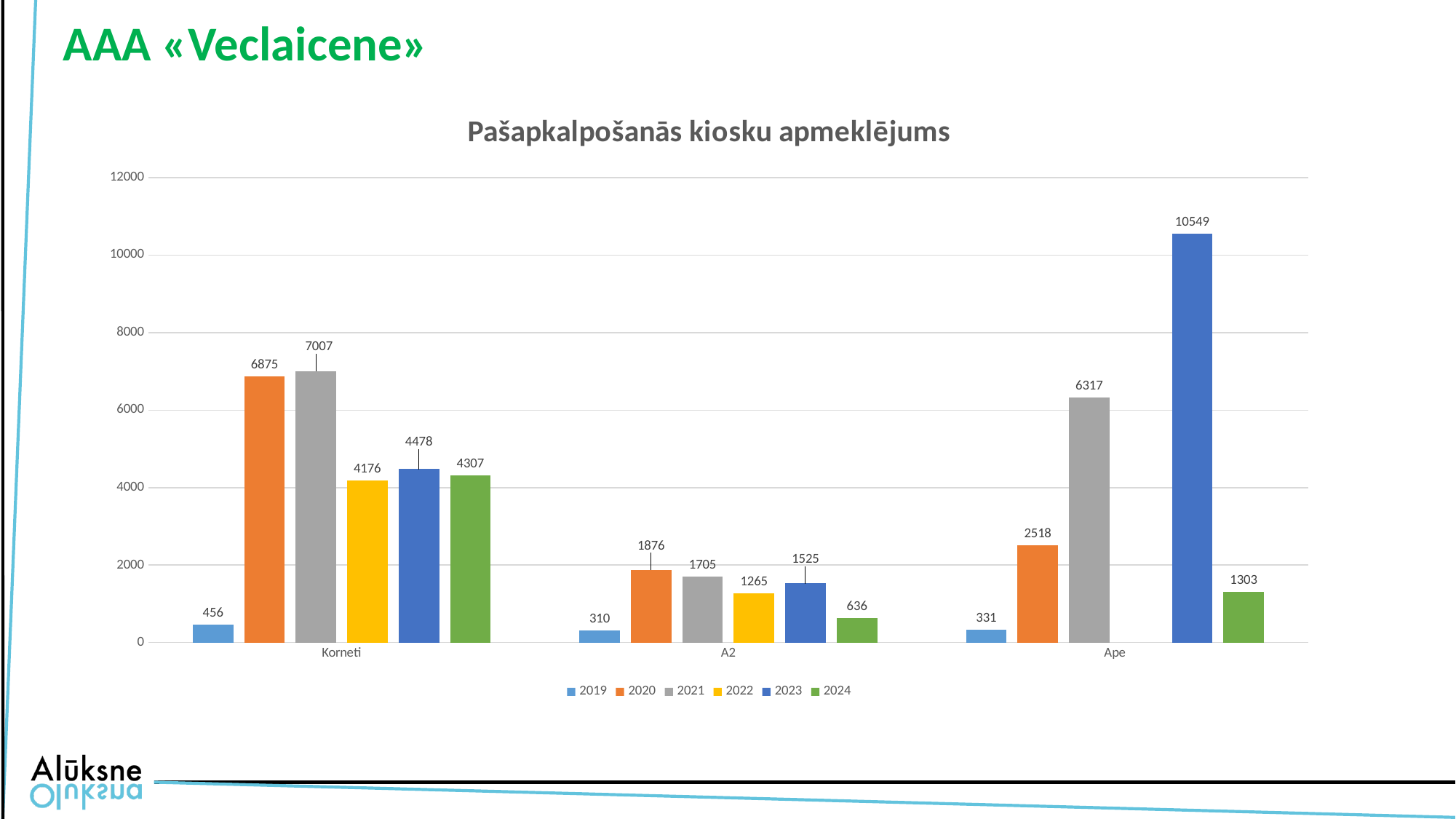
Which year has the lowest value in the A2 group? 2019 What is the difference between the 2021 and 2020 values in the Korneti group? 132 What kind of chart is shown on the slide? bar chart What is the value for 2023 in the Ape group? 10549 Is the value for 2021 in the Ape group greater or less than 6000? greater Which category has the highest value for the 2023 series? Ape What is the title of the chart? Pašapkalpošanās kiosku apmeklējums How many categories are shown on the x axis? 3 How many series does the legend list? 6 Which is larger: the 2024 value for Korneti or the 2024 value for Ape? Korneti What is the value for 2021 in the Korneti group? 7007 What is the value for 2022 in the A2 group? 1265